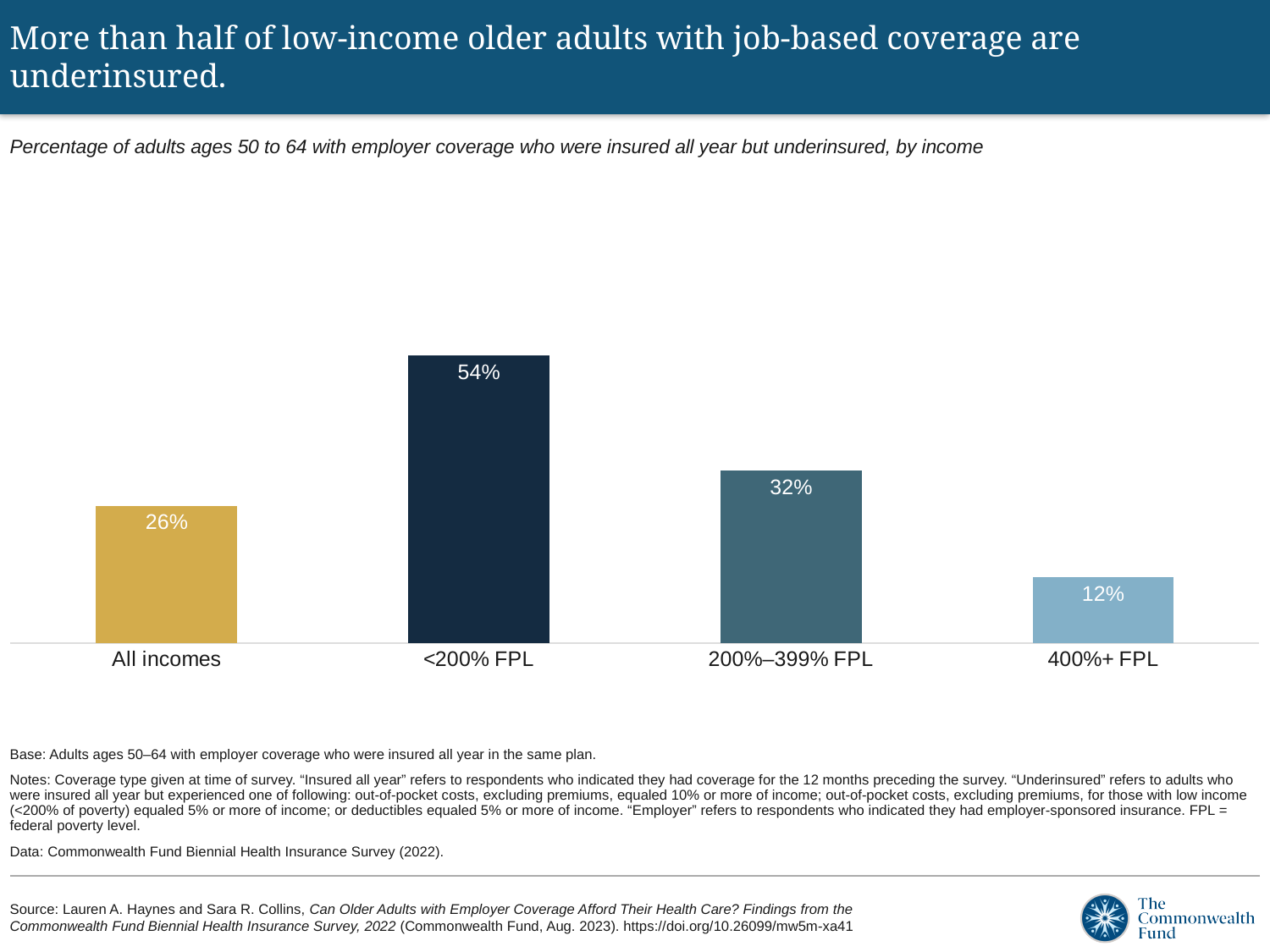
How many bars are shown in the chart? 4 What percentage of adults ages 50 to 64 with employer coverage were underinsured across all incomes? 26% What is the value shown for the 200%–399% FPL income group? 32% What is the value shown for the <200% FPL income group? 54% What is the difference in percentage points between the 200%–399% FPL group and the All incomes bar? 6 percentage points Which is larger, the value for 200%–399% FPL or the value for All incomes? 200%–399% FPL What is the value shown for the 400%+ FPL income group? 12% Which income group has the lowest percentage of underinsured adults? 400%+ FPL What is the difference in percentage points between the <200% FPL group and the 400%+ FPL group? 42 percentage points What type of chart is shown on the slide? Bar chart Which income group has the highest percentage of underinsured adults? <200% FPL Among the three FPL income groups, do the values rise or fall as income increases from left to right? Fall